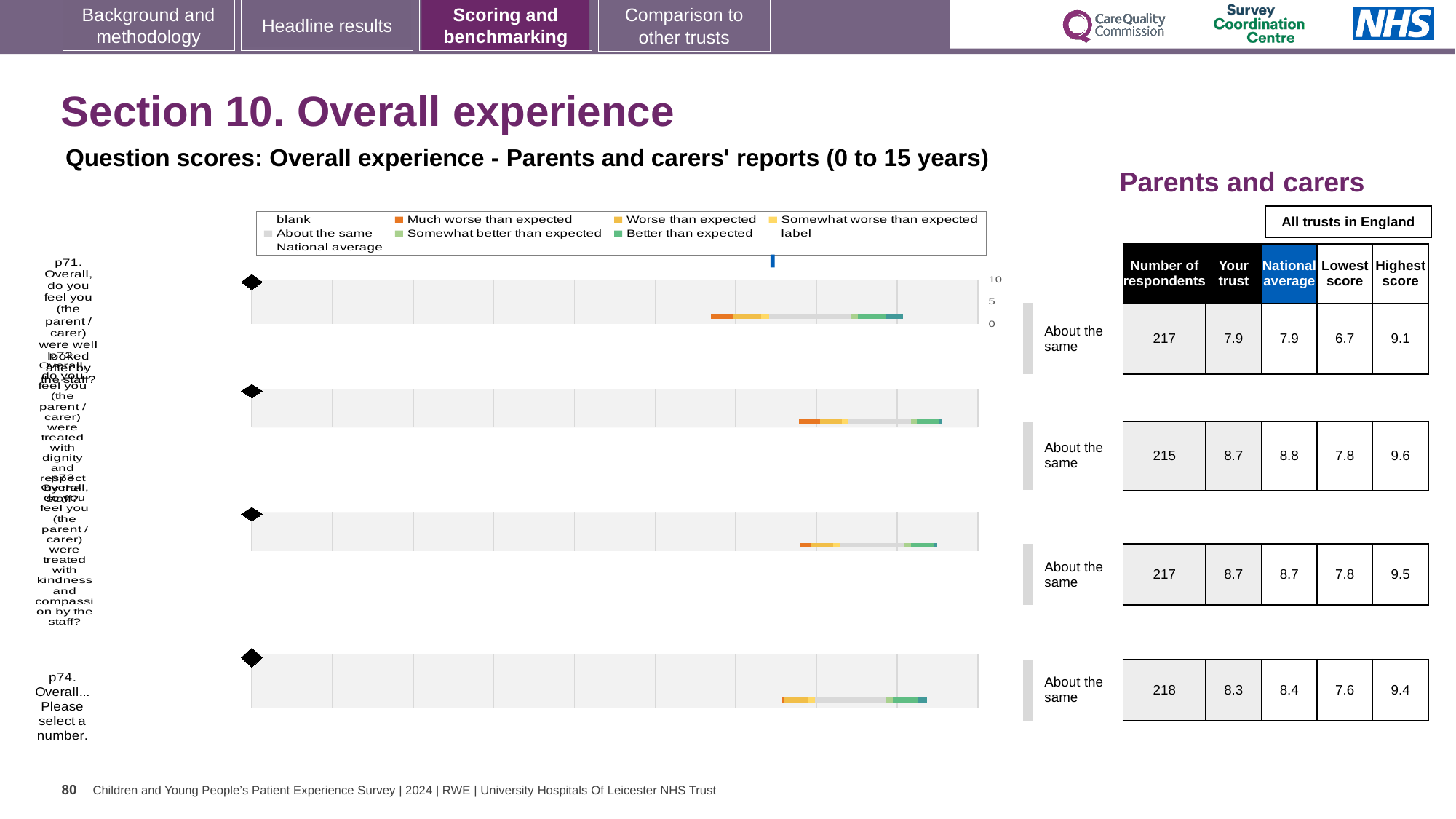
What is the highest score across all trusts in England for p74? 9.4 What is the national average score for the second row from the top of the chart? 8.8 What is the 'Your trust' score for p71 (the top row of the chart)? 7.9 What is the number of respondents for p74 (the bottom row of the chart)? 218 What colour does the legend use for 'Much worse than expected'? Orange Which question row has the lowest 'Your trust' score? p71 What kind of chart is used to show the question scores on this slide? bar chart What benchmark category is shown for p71? About the same What is the difference between the highest score and the lowest score for p71? 2.4 For p74, which is larger: the 'Your trust' score or the national average? National average For p74, how much higher is the national average than the 'Your trust' score? 0.1 How many question rows are plotted in the chart? 4